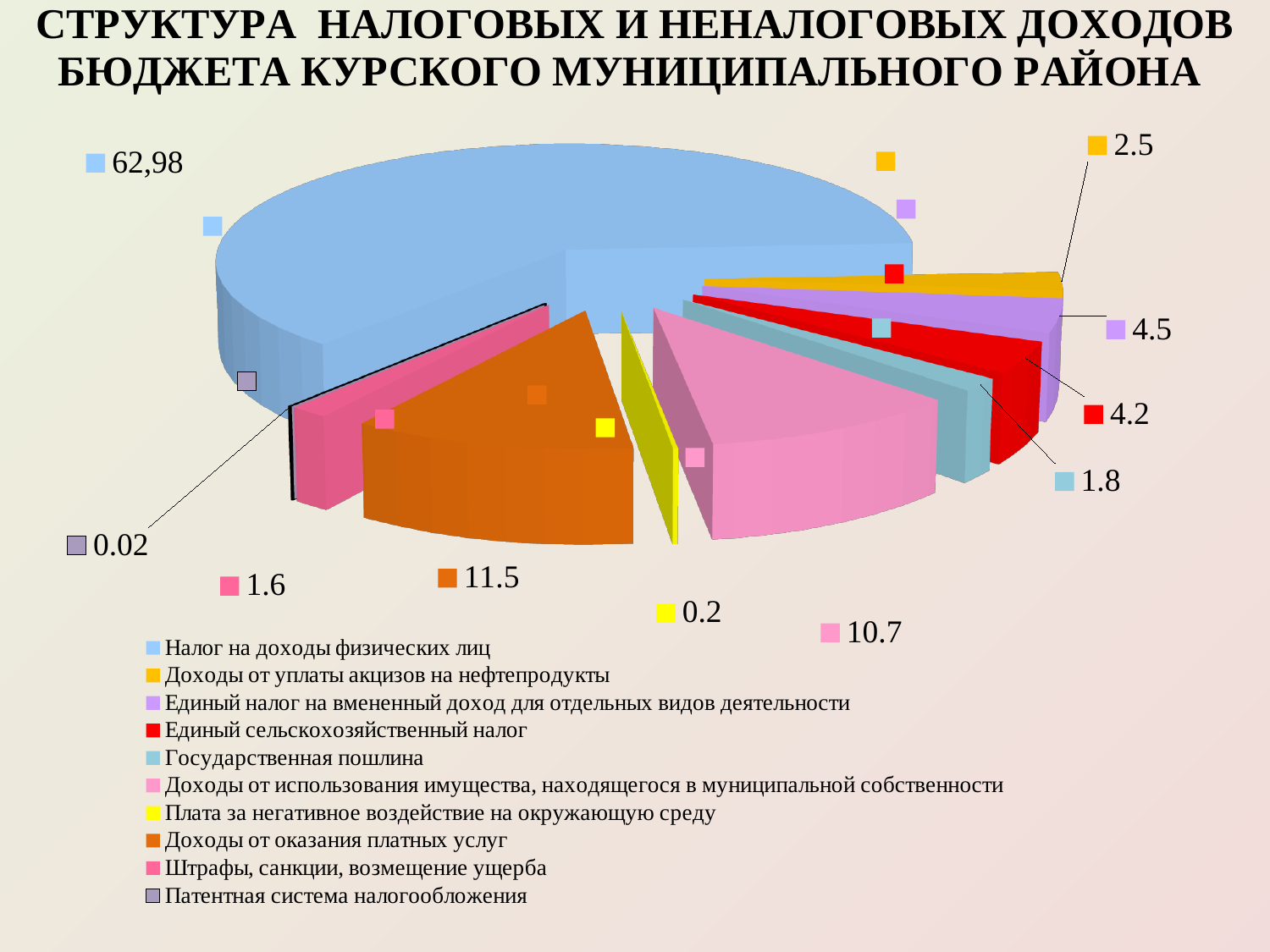
What is the difference between the values for Доходы от оказания платных услуг and Доходы от использования имущества, находящегося в муниципальной собственности? 0.8 How many categories does the legend list? 10 Which category has the smallest slice of the pie? Патентная система налогообложения What is the value shown for Доходы от оказания платных услуг? 11.5 What is the value shown for Патентная система налогообложения? 0.02 Which is larger: the value for Единый налог на вмененный доход для отдельных видов деятельности or the value for Единый сельскохозяйственный налог? Единый налог на вмененный доход для отдельных видов деятельности What type of chart is shown on the slide? pie chart Which category has the largest slice of the pie? Налог на доходы физических лиц What is the value shown for Доходы от использования имущества, находящегося в муниципальной собственности? 10.7 What colour is the slice for Плата за негативное воздействие на окружающую среду? yellow What is the value shown for Государственная пошлина? 1.8 What is the value shown for Налог на доходы физических лиц? 62,98